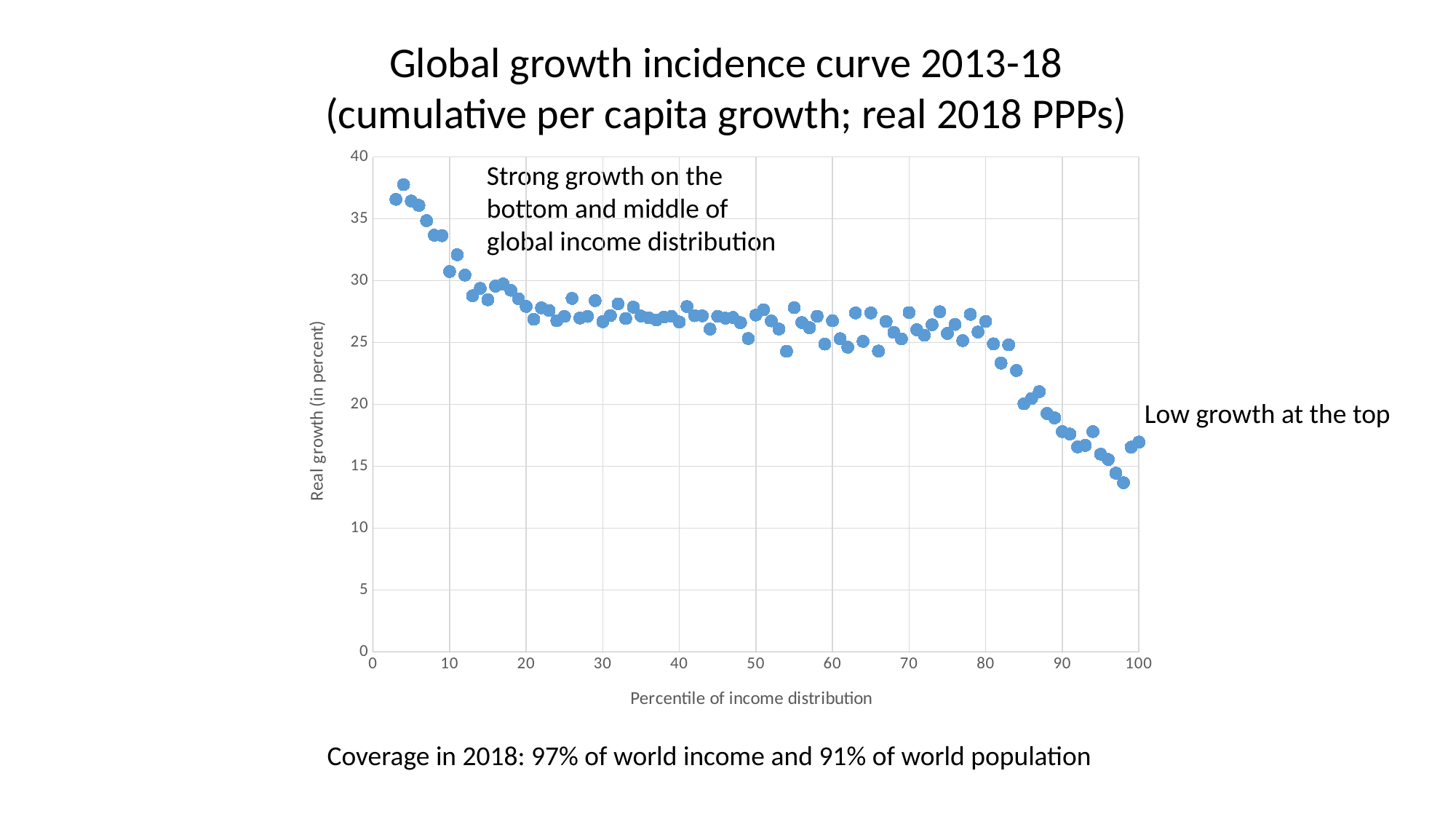
Is the real growth value at the 90th percentile greater or less than 20? less Which has higher real growth: the 5th percentile or the 95th percentile? 5th percentile What kind of chart is shown on the slide? Scatter chart Is the real growth value at the 80th percentile greater or less than 25? greater Overall, do the real growth values rise or fall as the percentile of income distribution increases? Fall Is the real growth value at the 95th percentile greater or less than 20? less What is the label of the y axis? Real growth (in percent) Which has higher real growth: the 20th percentile or the 90th percentile? 20th percentile What is the label of the x axis? Percentile of income distribution